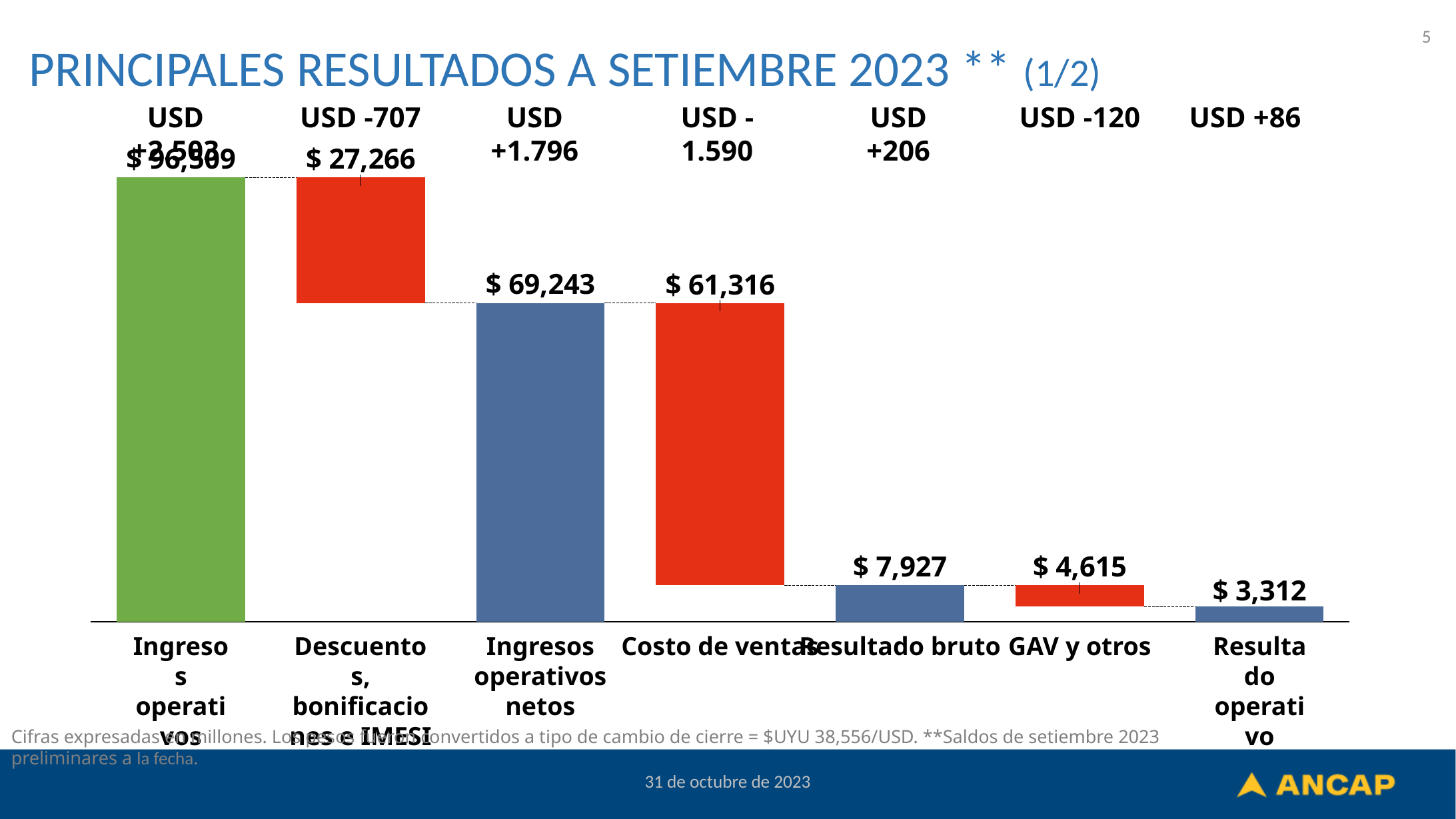
Which is larger, Descuentos, bonificaciones e IMESI or Resultado bruto? Descuentos, bonificaciones e IMESI Which category has the tallest bar? Ingresos operativos What USD figure is shown above the Costo de ventas bar? USD -1.590 What is the value shown for Resultado bruto? $ 7,927 What colour is the Costo de ventas bar? Red What is the value shown for Costo de ventas? $ 61,316 What is the difference between Ingresos operativos netos and Costo de ventas? $ 7,927 What is the value shown for Resultado operativo? $ 3,312 What is the value shown for Ingresos operativos netos? $ 69,243 Which category has the smallest value? Resultado operativo What is the value shown for GAV y otros? $ 4,615 How many categories are shown on the x axis? 7